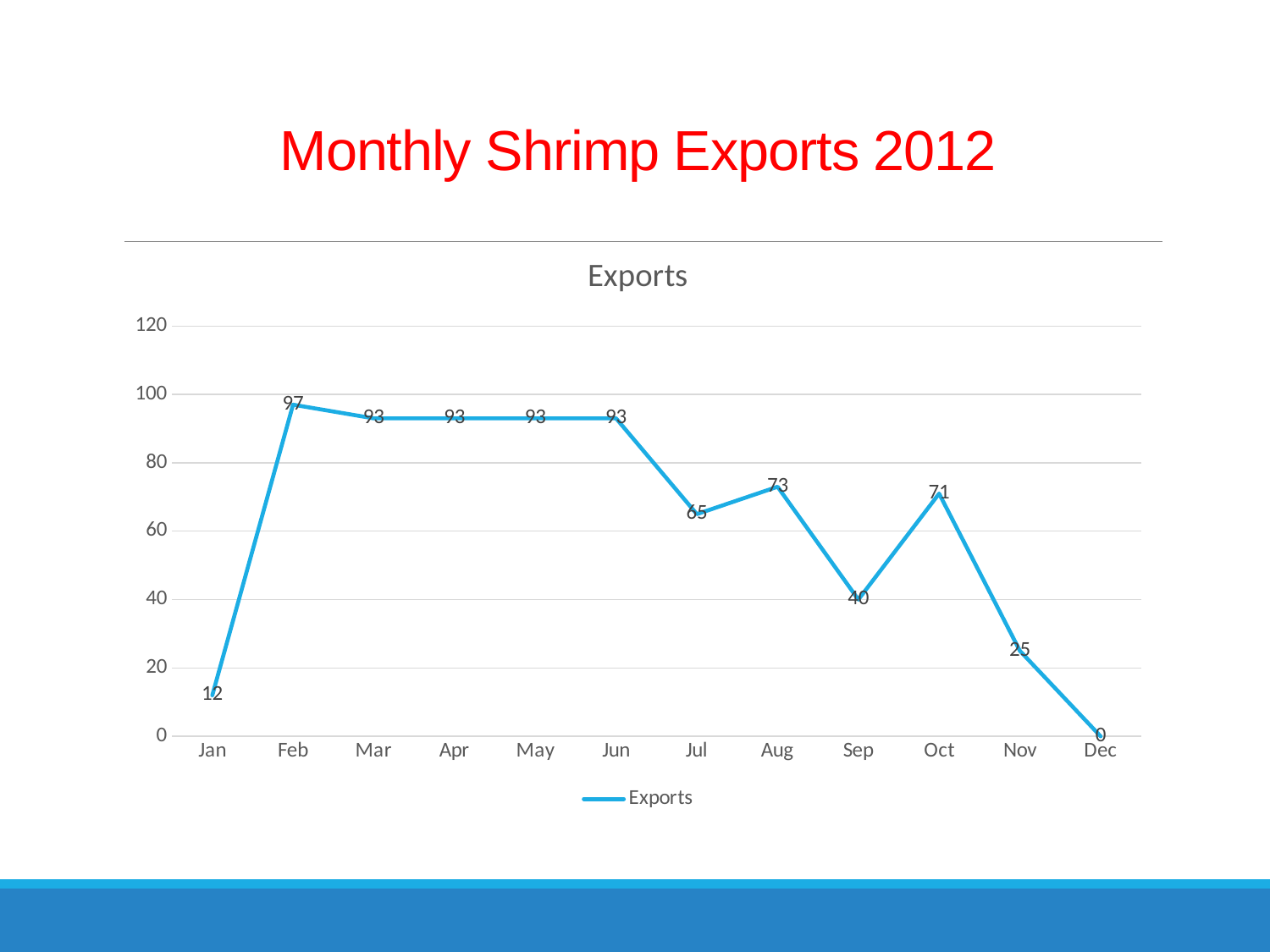
What is the difference between the values for Feb and Jan? 85 How many months are plotted on the x axis? 12 What is the difference between the values for Aug and Jul? 8 Do the values rise or fall from Jun to Dec? fall What is the value for Nov? 25 Which is larger, the value for Oct or the value for Sep? Oct What is the value for Sep? 40 What kind of chart is shown? line chart Which month has the lowest value? Dec Which month has the highest value? Feb How many series does the legend list? 1 What is the value for Feb? 97